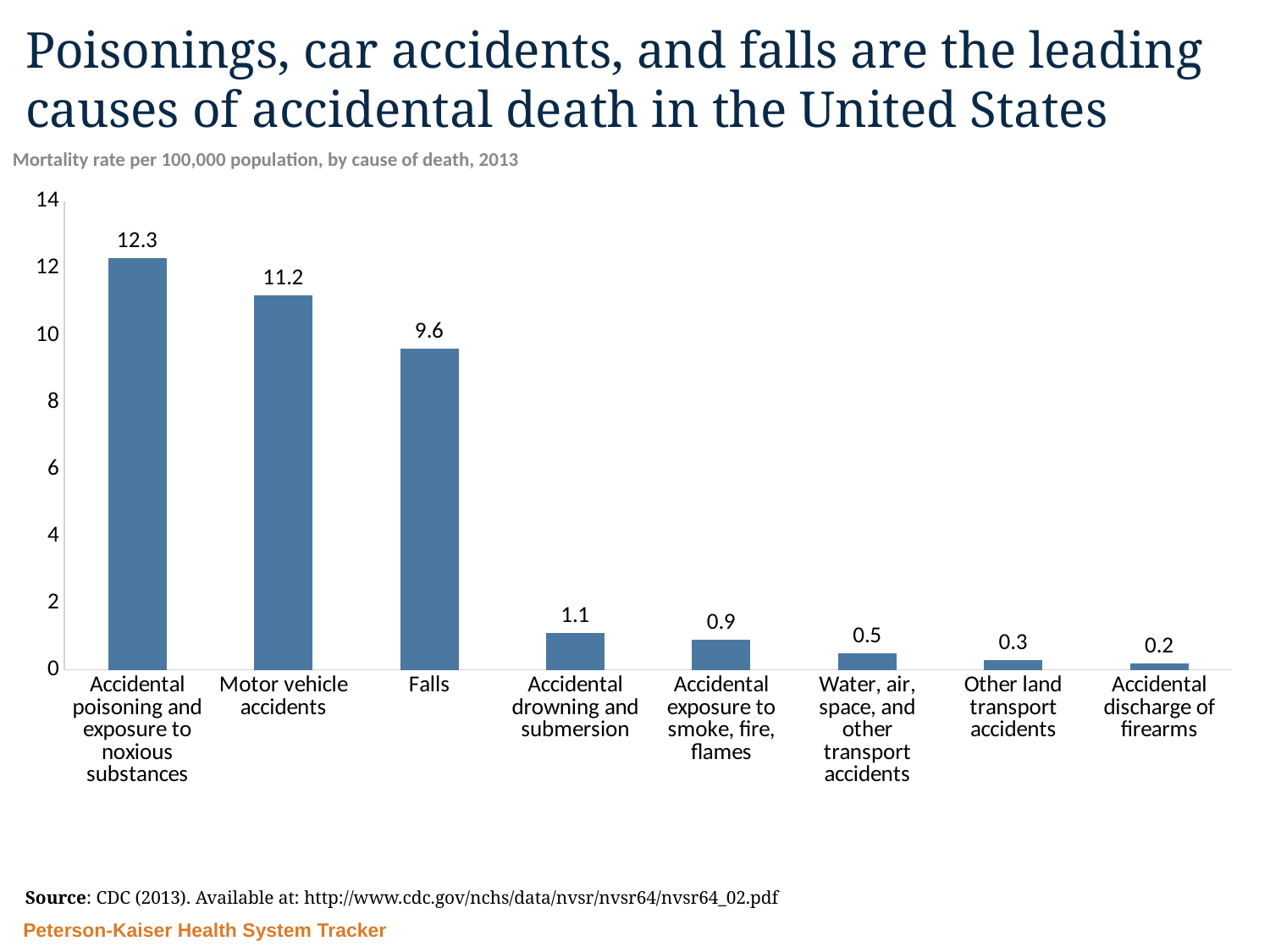
Which has a higher mortality rate, Falls or Accidental exposure to smoke, fire, flames? Falls How many causes of death are shown in the chart? 8 Is the mortality rate for Motor vehicle accidents greater or less than 10? greater What is the mortality rate for Accidental drowning and submersion? 1.1 What is the mortality rate for Motor vehicle accidents? 11.2 What is the difference between the mortality rates for Accidental poisoning and exposure to noxious substances and Motor vehicle accidents? 1.1 What is the mortality rate for Falls? 9.6 What is the subtitle of the chart? Mortality rate per 100,000 population, by cause of death, 2013 Which cause of death has the highest mortality rate? Accidental poisoning and exposure to noxious substances What is the mortality rate for Accidental discharge of firearms? 0.2 Which cause of death has the lowest mortality rate? Accidental discharge of firearms What kind of chart is shown on the slide? bar chart